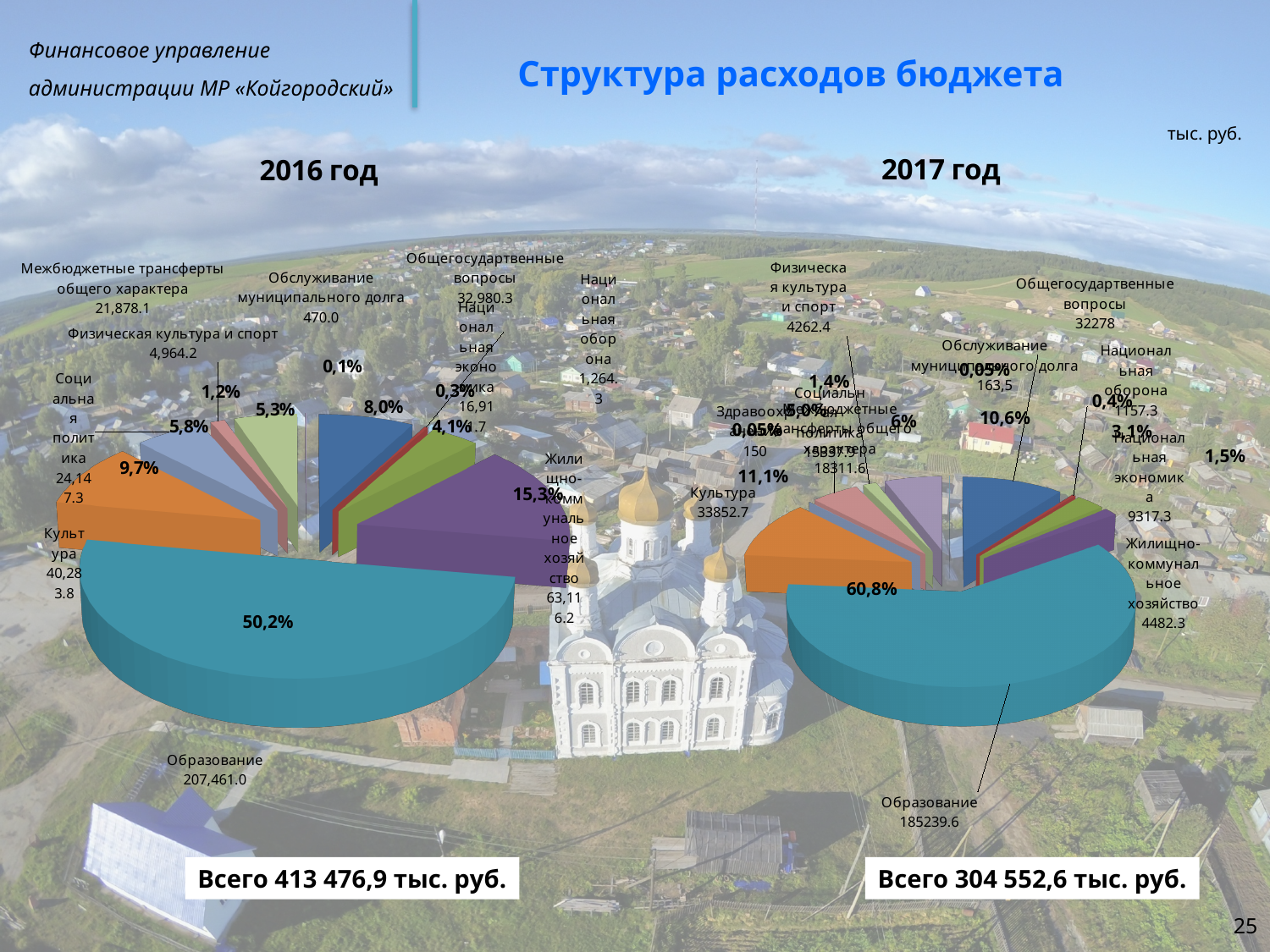
In the 2016 год chart, what value is shown for Образование? 207,461.0 In the 2017 год chart, what value is shown for Физическая культура и спорт? 4262.4 In the 2017 год chart, what value is shown for Общегосударственные вопросы? 32278 What total is shown below the 2017 год chart? Всего 304 552,6 тыс. руб. In the 2016 год chart, which category has the largest slice? Образование In the 2017 год chart, which category has the largest slice? Образование In the 2017 год chart, what share of the pie does Образование take? 60,8% What type of chart is used for the 2016 год chart? pie chart In the 2016 год chart, what value is shown for Обслуживание муниципального долга? 470.0 In the 2016 год chart, which is larger: the slice for Культура or the slice for Физическая культура и спорт? Культура In the 2017 год chart, what value is shown for Образование? 185239.6 In the 2016 год chart, what share of the pie does Образование take? 50,2%